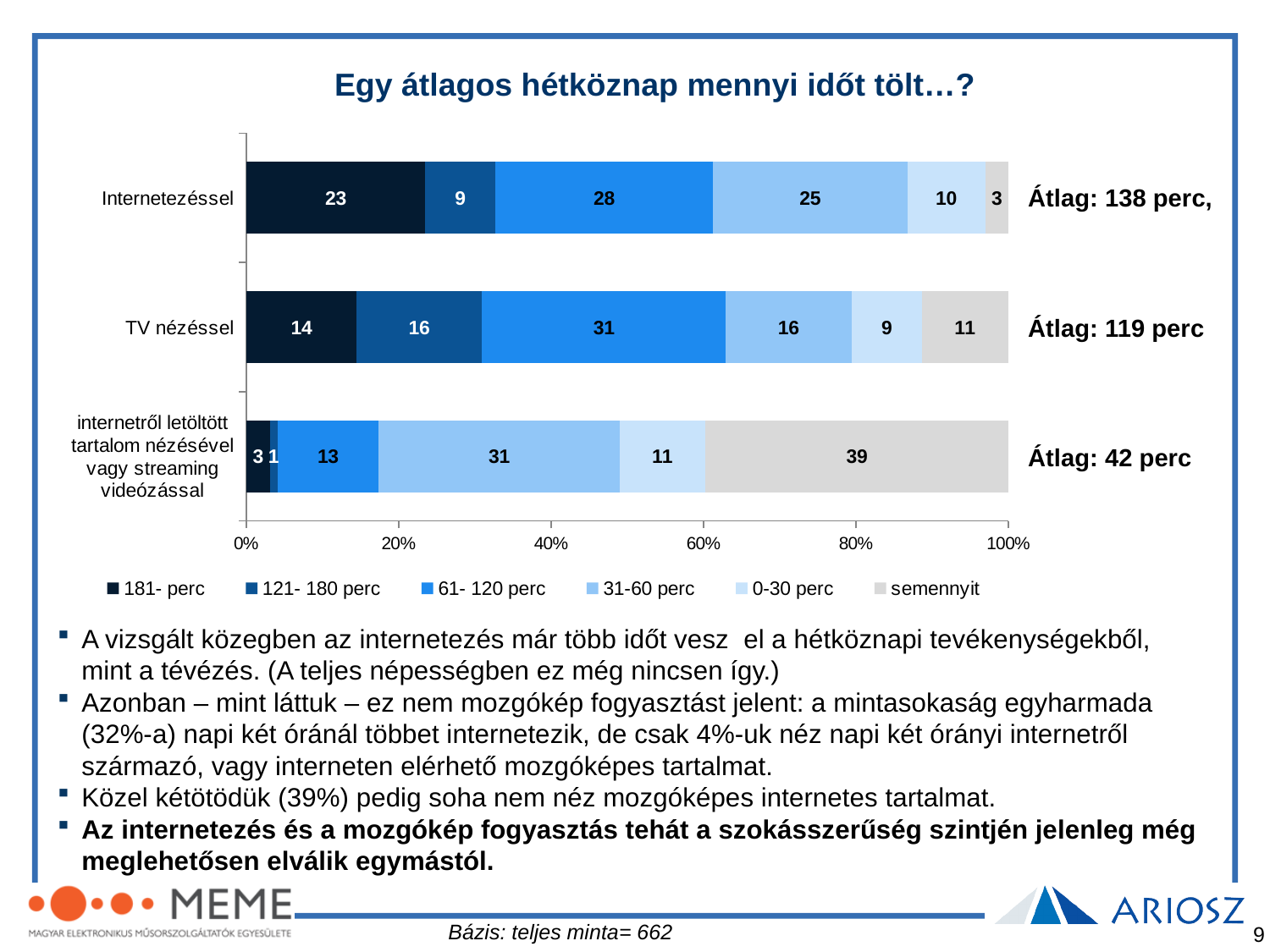
Which is larger: the '0-30 perc' value for 'Internetezéssel' or for 'TV nézéssel'? Internetezéssel What average (Átlag) is shown next to the 'TV nézéssel' bar? 119 perc How many categories are plotted on the chart? 3 What is the value of the '31-60 perc' segment for 'Internetezéssel'? 25 Which category has the highest value in the 'semennyit' series? internetről letöltött tartalom nézésével vagy streaming videózással What is the value of the '61- 120 perc' segment for 'TV nézéssel'? 31 What is the value of the '181- perc' segment for 'Internetezéssel'? 23 How many series does the legend list? 6 What is the difference between the '121- 180 perc' values for 'TV nézéssel' and 'Internetezéssel'? 7 What is the value of the 'semennyit' segment for 'internetről letöltött tartalom nézésével vagy streaming videózással'? 39 Which category has the lowest value in the '181- perc' series? internetről letöltött tartalom nézésével vagy streaming videózással What kind of chart is shown on the slide? stacked bar chart